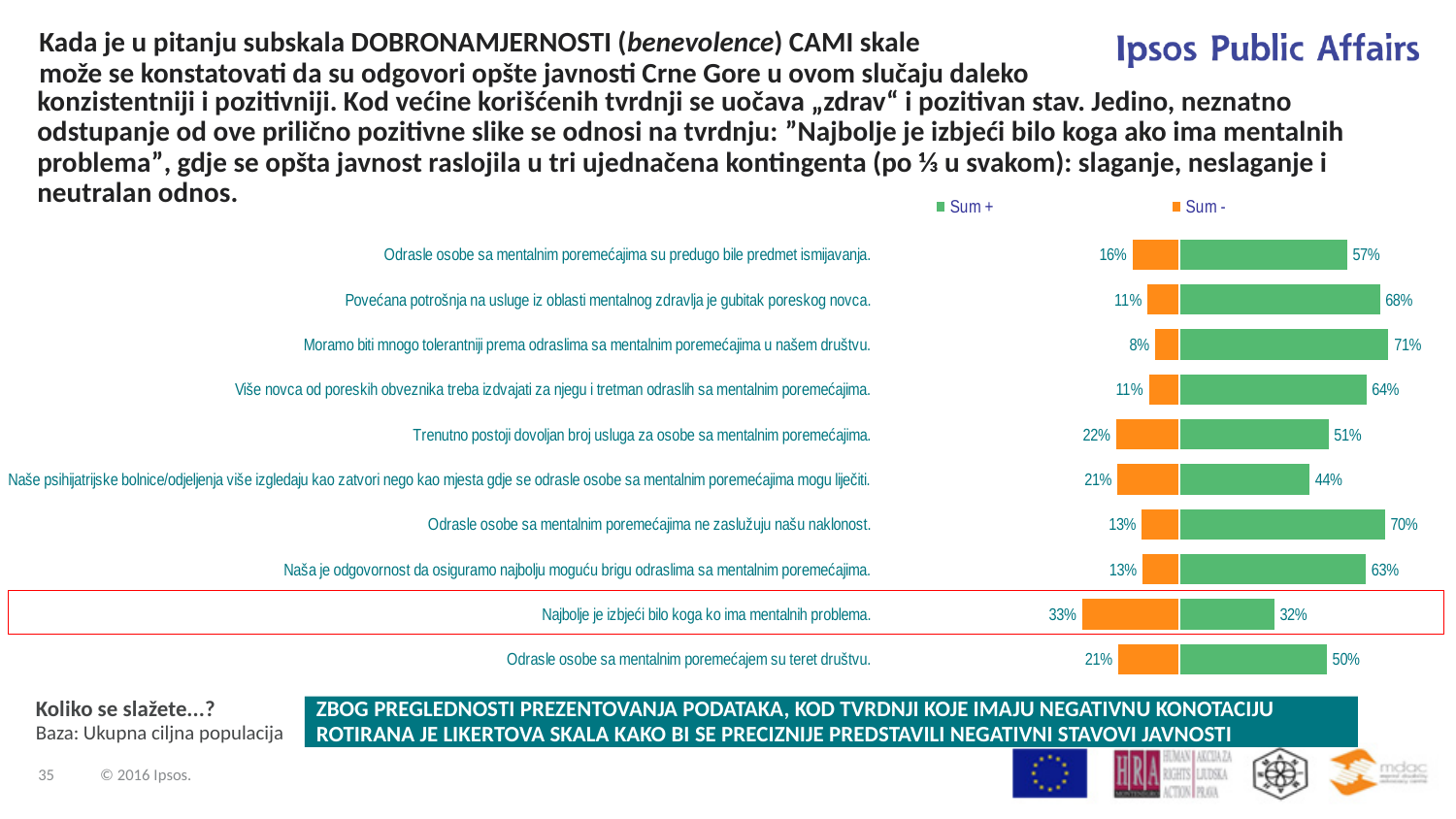
How many series does the chart legend list? 2 What is the Sum - value for the statement "Najbolje je izbjeći bilo koga ko ima mentalnih problema."? 33% How many statements (categories) are plotted in the chart? 10 What is the Sum + value for the statement "Naše psihijatrijske bolnice/odjeljenja više izgledaju kao zatvori nego kao mjesta gdje se odrasle osobe sa mentalnim poremećajima mogu liječiti."? 44% What is the difference between the Sum + and Sum - values for the statement "Odrasle osobe sa mentalnim poremećajima su predugo bile predmet ismijavanja."? 41% Which statement has the highest Sum + value? Moramo biti mnogo tolerantniji prema odraslima sa mentalnim poremećajima u našem društvu. Which statement has the lowest Sum - value? Moramo biti mnogo tolerantniji prema odraslima sa mentalnim poremećajima u našem društvu. Which colour represents the Sum - series in the chart? orange What kind of chart is shown on the slide? bar chart Which statement has the lowest Sum + value? Najbolje je izbjeći bilo koga ko ima mentalnih problema. What is the Sum + value for the statement "Moramo biti mnogo tolerantniji prema odraslima sa mentalnim poremećajima u našem društvu."? 71% Which is larger: the Sum + value for "Trenutno postoji dovoljan broj usluga za osobe sa mentalnim poremećajima." or the Sum + value for "Odrasle osobe sa mentalnim poremećajem su teret društvu."? Trenutno postoji dovoljan broj usluga za osobe sa mentalnim poremećajima.